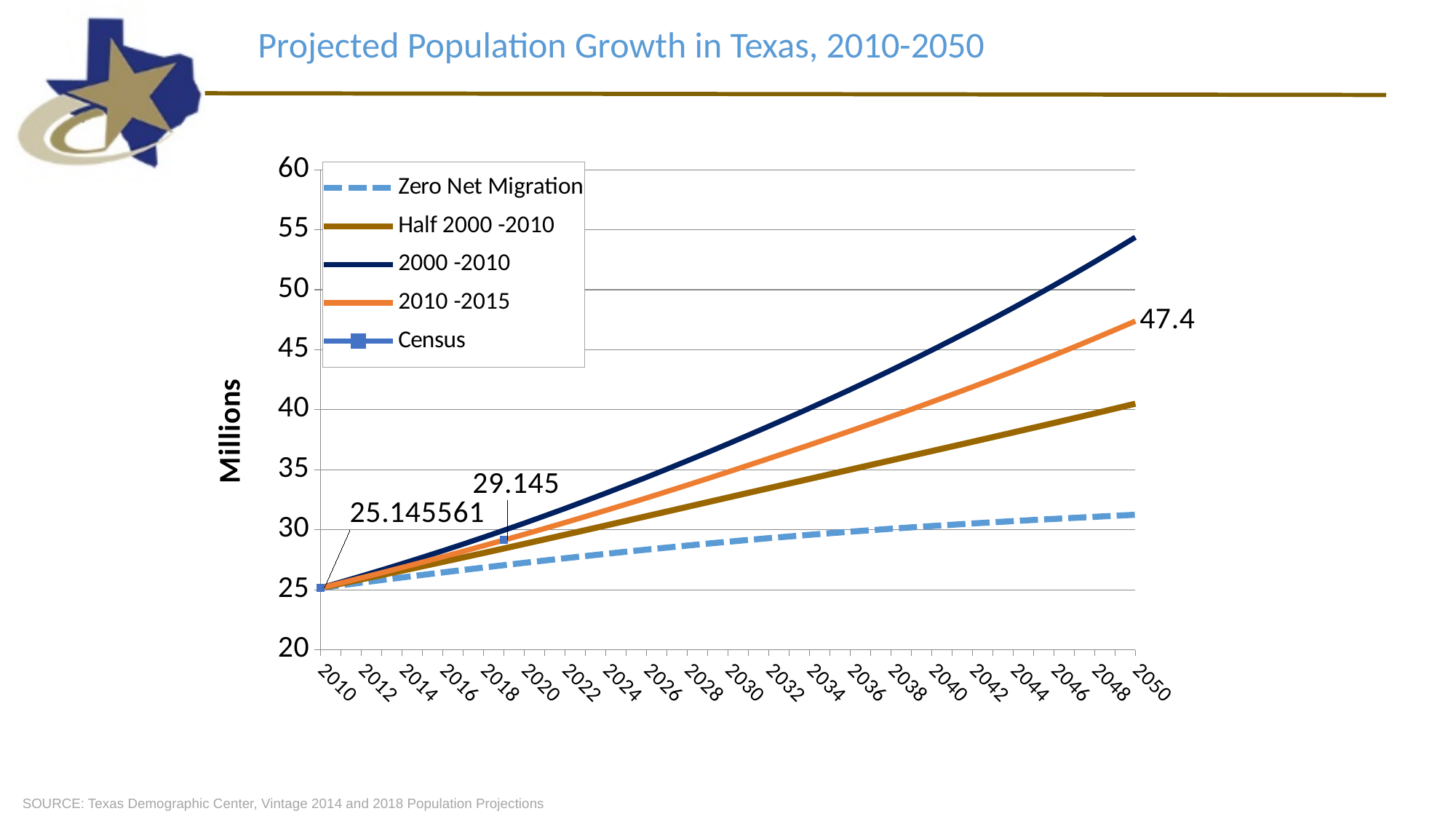
Which is larger in 2050, the 2000 -2010 series or the 2010 -2015 series? 2000 -2010 What kind of chart is shown on the slide? line chart What is the label on the vertical axis? Millions Which series has the highest value in 2050? 2000 -2010 Is the value of the 2000 -2010 series in 2050 greater or less than 50? greater What is the Census value labelled for 2010? 25.145561 How many series does the legend list? 5 Is the value of the Zero Net Migration series in 2050 greater or less than 35? less What value is labelled at the end of the 2010 -2015 line in 2050? 47.4 Which series has the lowest value in 2050? Zero Net Migration Do the projection lines rise or fall from 2010 to 2050? rise